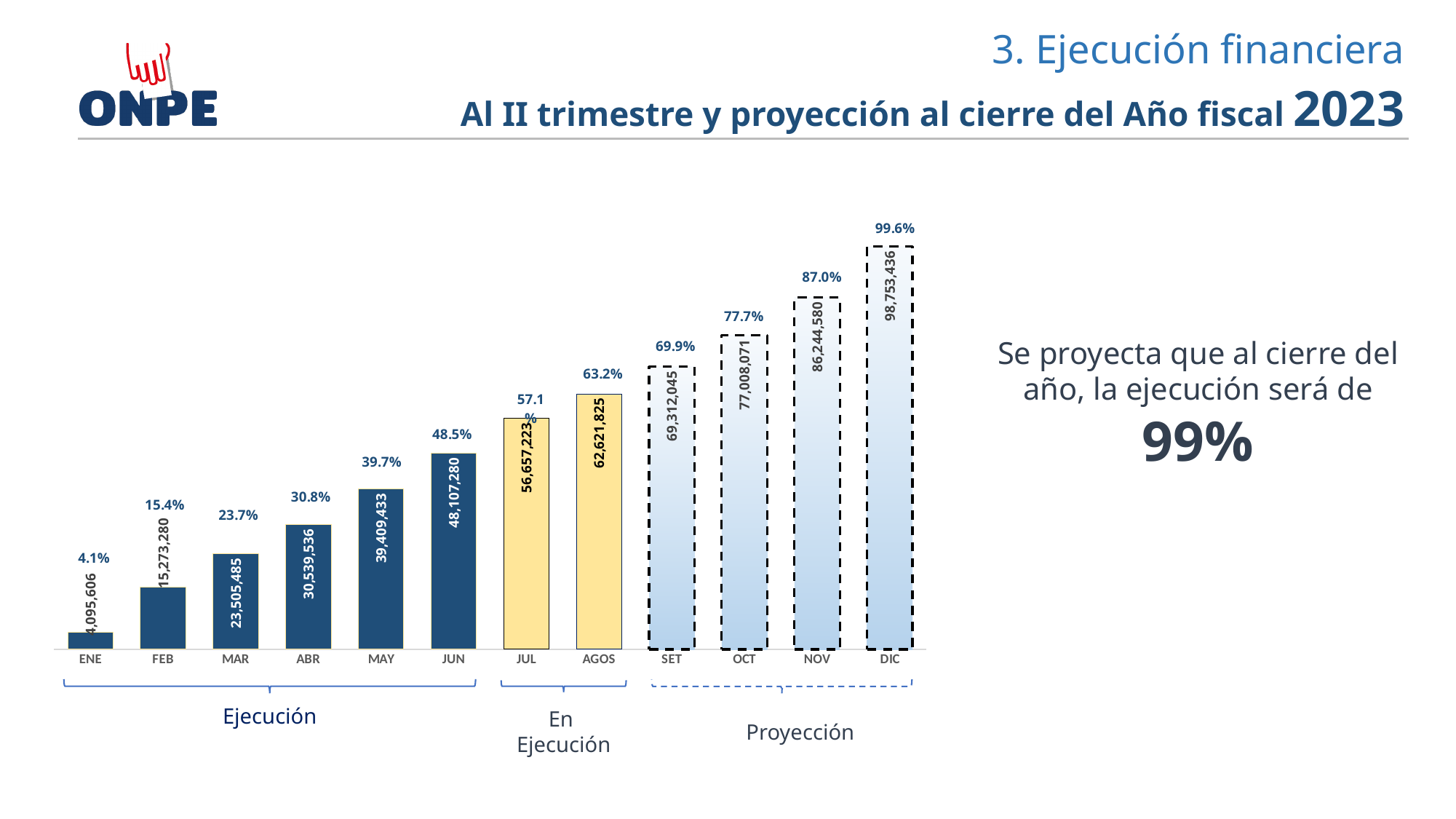
What is the value shown for JUN? 48,107,280 Which month has the highest value? DIC By how many percentage points does the DIC percentage exceed the NOV percentage? 12.6 What is the difference between the values for DIC and NOV? 12,508,856 What kind of chart is shown? Bar chart What percentage is shown above the DIC bar? 99.6% Which month has the lowest value? ENE Which is larger, the value for JUL or the value for SET? SET Do the values rise or fall from ENE to DIC? Rise How many months are shown on the x axis? 12 What is the value shown for AGOS? 62,621,825 What percentage is shown above the MAR bar? 23.7%